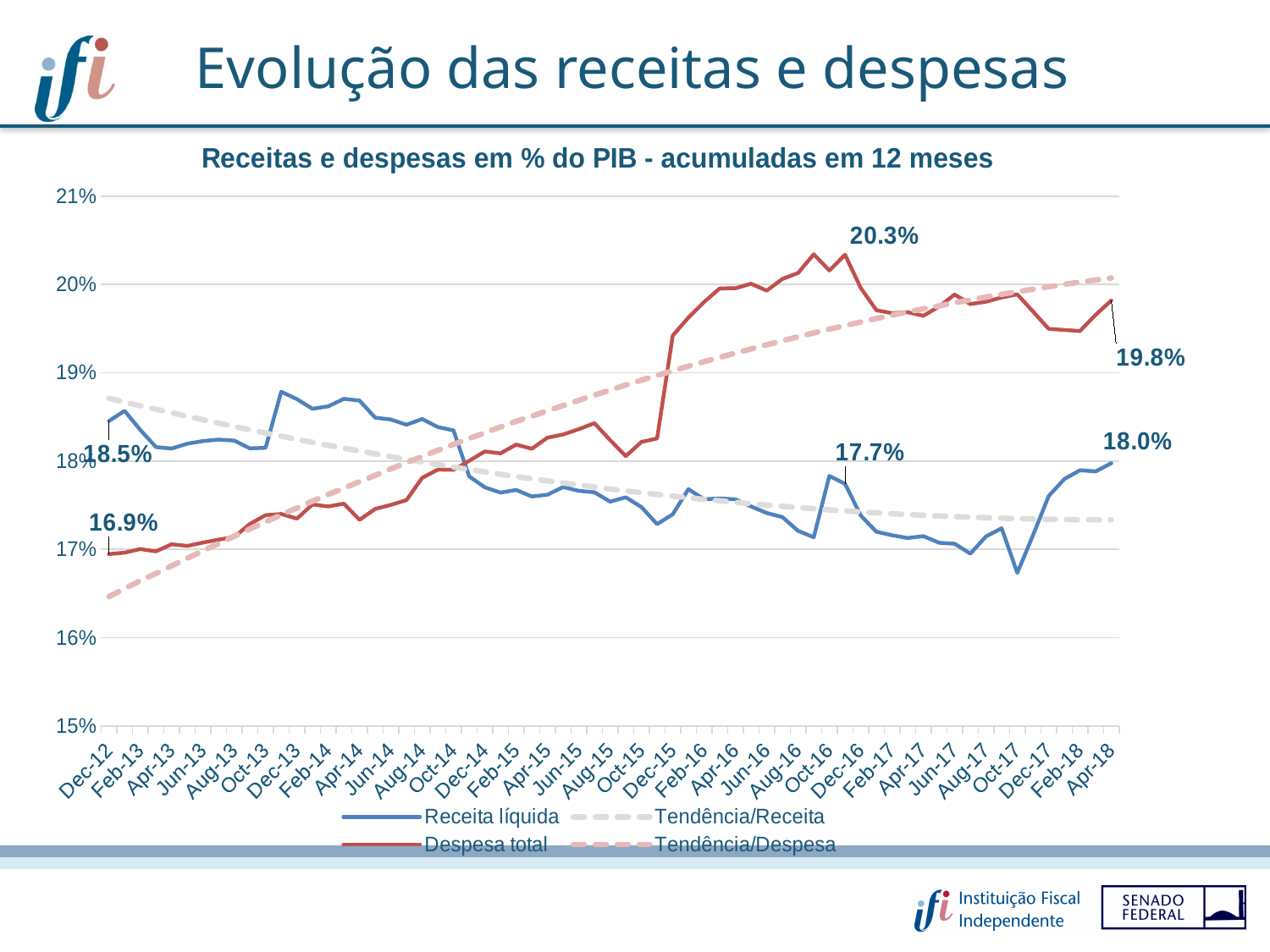
By how many percentage points did Despesa total change between Dec-12 (16.9%) and Apr-18 (19.8%)? 2.9 percentage points Does the Despesa total line generally rise or fall from Dec-12 to Apr-18? Rise What kind of chart is shown on the slide? Line chart What is the highest labelled value on the Despesa total line? 20.3% What is the value of Despesa total at Apr-18? 19.8% Is the value of Receita líquida at Oct-17 greater or less than 17%? less What is the value of Receita líquida at Dec-12? 18.5% How many series does the legend list? 4 What is the value of Despesa total at Dec-12? 16.9% At Apr-18, which is higher: Despesa total or Receita líquida? Despesa total What is the value of Receita líquida at Apr-18? 18.0% At Dec-12, which is higher: Receita líquida or Despesa total? Receita líquida